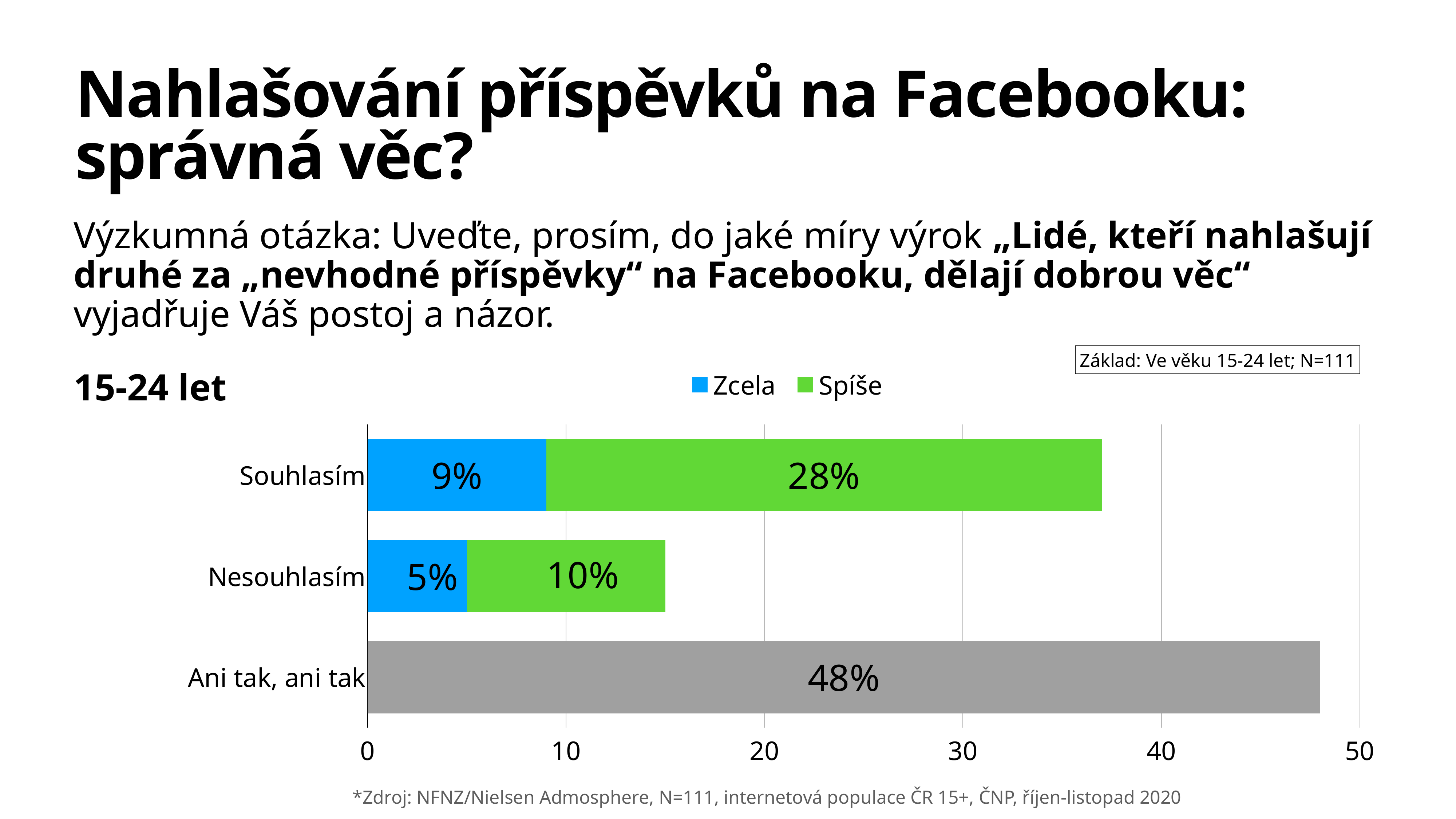
What is the 'Spíše' value for Nesouhlasím? 10% What is the 'Zcela' value for Souhlasím? 9% What is the total of the stacked bar for Nesouhlasím? 15% What kind of chart is shown on the slide? bar chart How many categories are shown on the y axis of the chart? 3 What is the value for 'Ani tak, ani tak'? 48% How many series does the legend list? 2 Which is larger: the 'Zcela' value for Souhlasím or the 'Zcela' value for Nesouhlasím? Souhlasím What is the 'Spíše' value for Souhlasím? 28% What is the difference between the 'Spíše' values for Souhlasím and Nesouhlasím? 18% What is the 'Zcela' value for Nesouhlasím? 5% What is the total of the stacked bar for Souhlasím? 37%